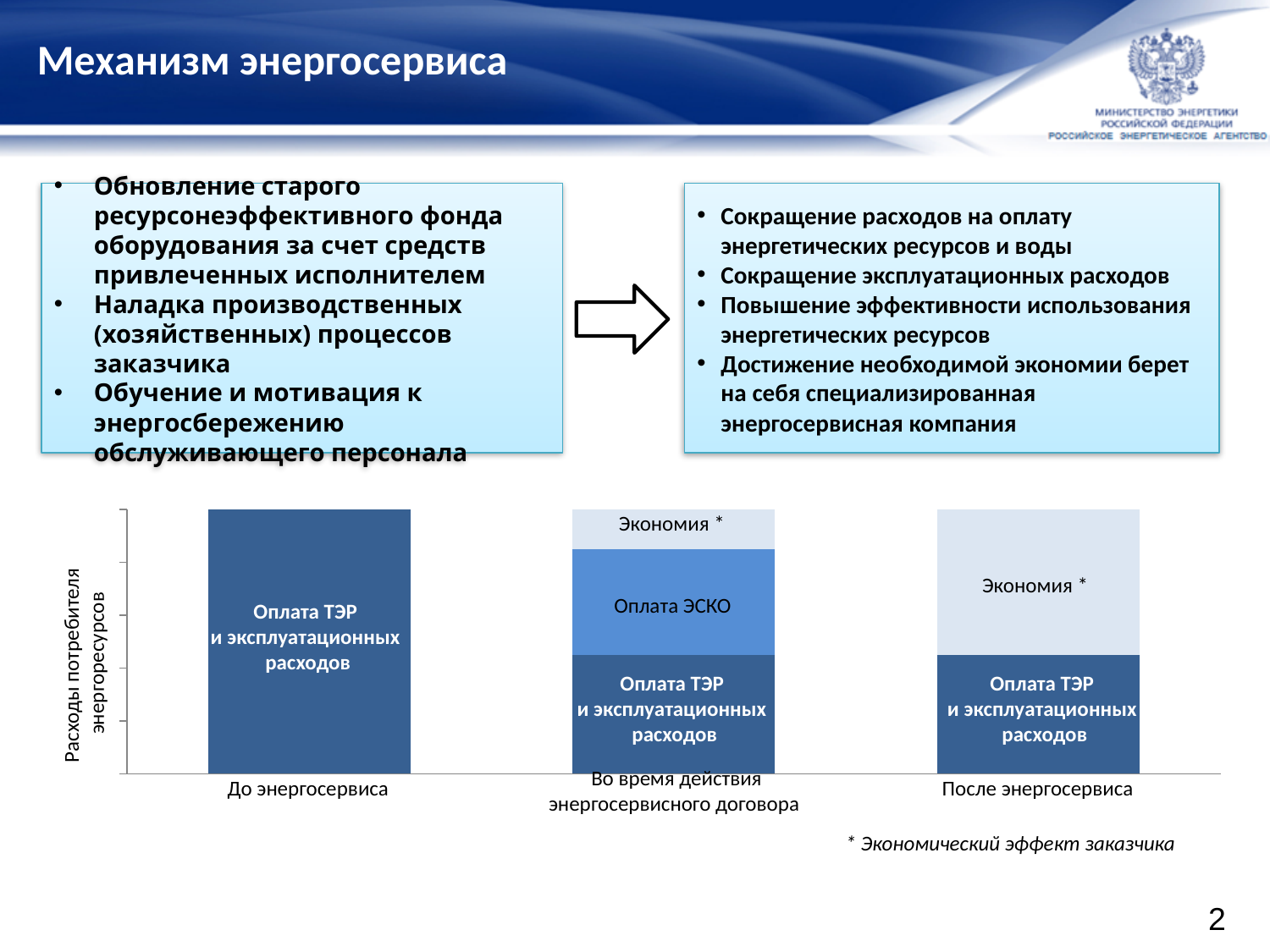
What is the label of the last category on the x axis of the chart? После энергосервиса Which bar in the chart contains the segment 'Оплата ЭСКО'? Во время действия энергосервисного договора How many categories (bars) are shown along the x axis of the chart? 3 Does the 'Оплата ТЭР и эксплуатационных расходов' segment rise or fall from 'До энергосервиса' to 'Во время действия энергосервисного договора'? Fall Is the 'Экономия' segment larger for 'Во время действия энергосервисного договора' or for 'После энергосервиса'? После энергосервиса How many segments make up the bar for 'После энергосервиса'? 2 What kind of chart is shown at the bottom of the slide? Stacked bar chart What is the label of the first category on the x axis of the chart? До энергосервиса How many segments make up the bar for 'Во время действия энергосервисного договора'? 3 Which bar in the chart consists only of the segment 'Оплата ТЭР и эксплуатационных расходов'? До энергосервиса Which segment appears at the top of the bar for 'Во время действия энергосервисного договора'? Экономия * Is the 'Оплата ТЭР и эксплуатационных расходов' segment larger for 'До энергосервиса' or for 'После энергосервиса'? До энергосервиса